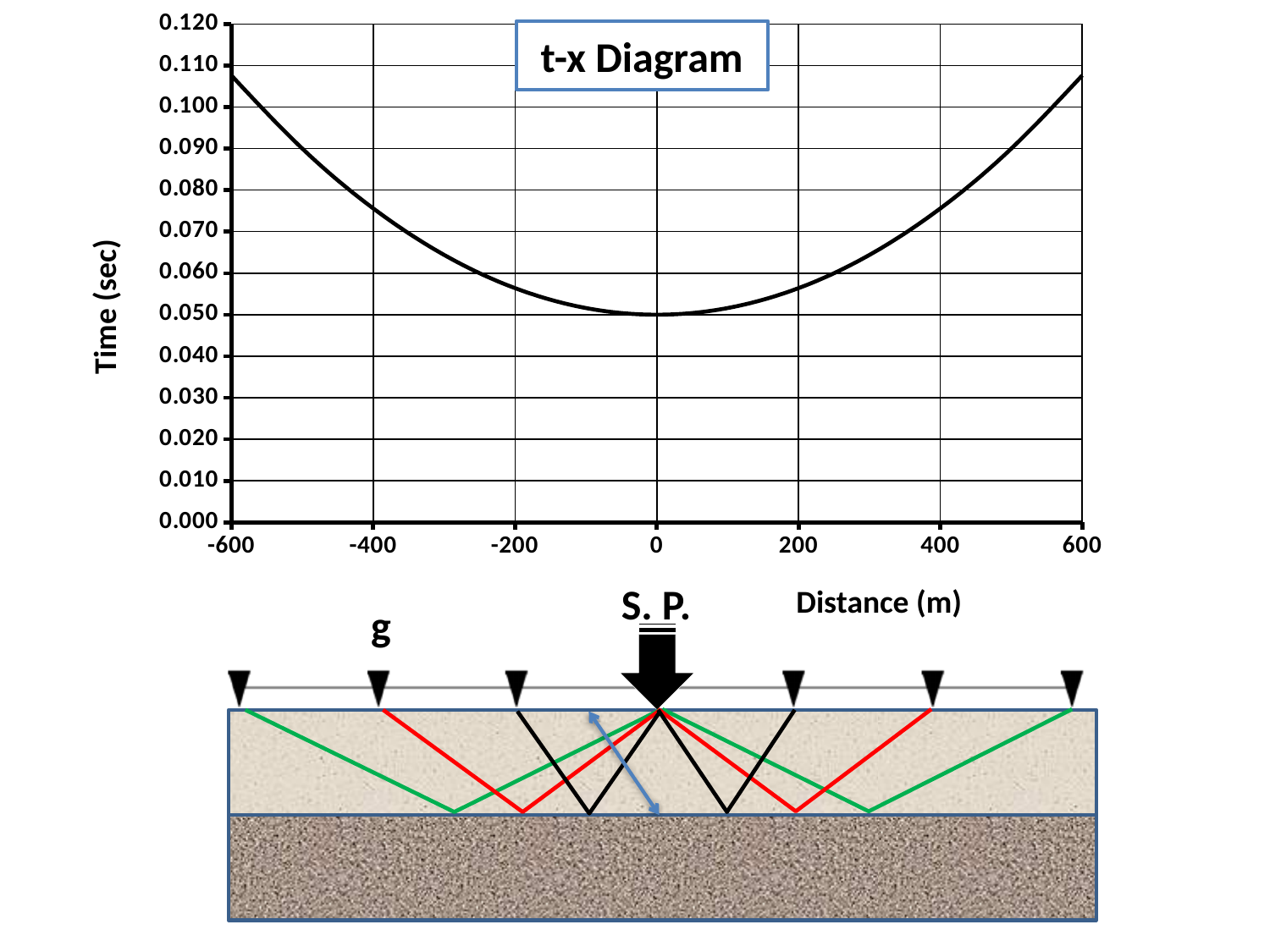
What is the time value of the curve at a distance of 0 m? 0.050 Does the time value rise or fall as distance increases from -600 to 0 m? fall Is the time value at a distance of -400 m greater or less than 0.080? less What kind of chart is the t-x Diagram? line chart Is the time value at a distance of -600 m greater or less than 0.100? greater Which has the larger time value: the curve at -600 m or at 0 m? -600 m Does the time value rise or fall as distance increases from 0 to 600 m? rise What is the label of the vertical axis of the chart? Time (sec) Is the time value at a distance of 200 m greater or less than 0.060? less What is the title of the chart? t-x Diagram At which distance does the curve reach its lowest time? 0